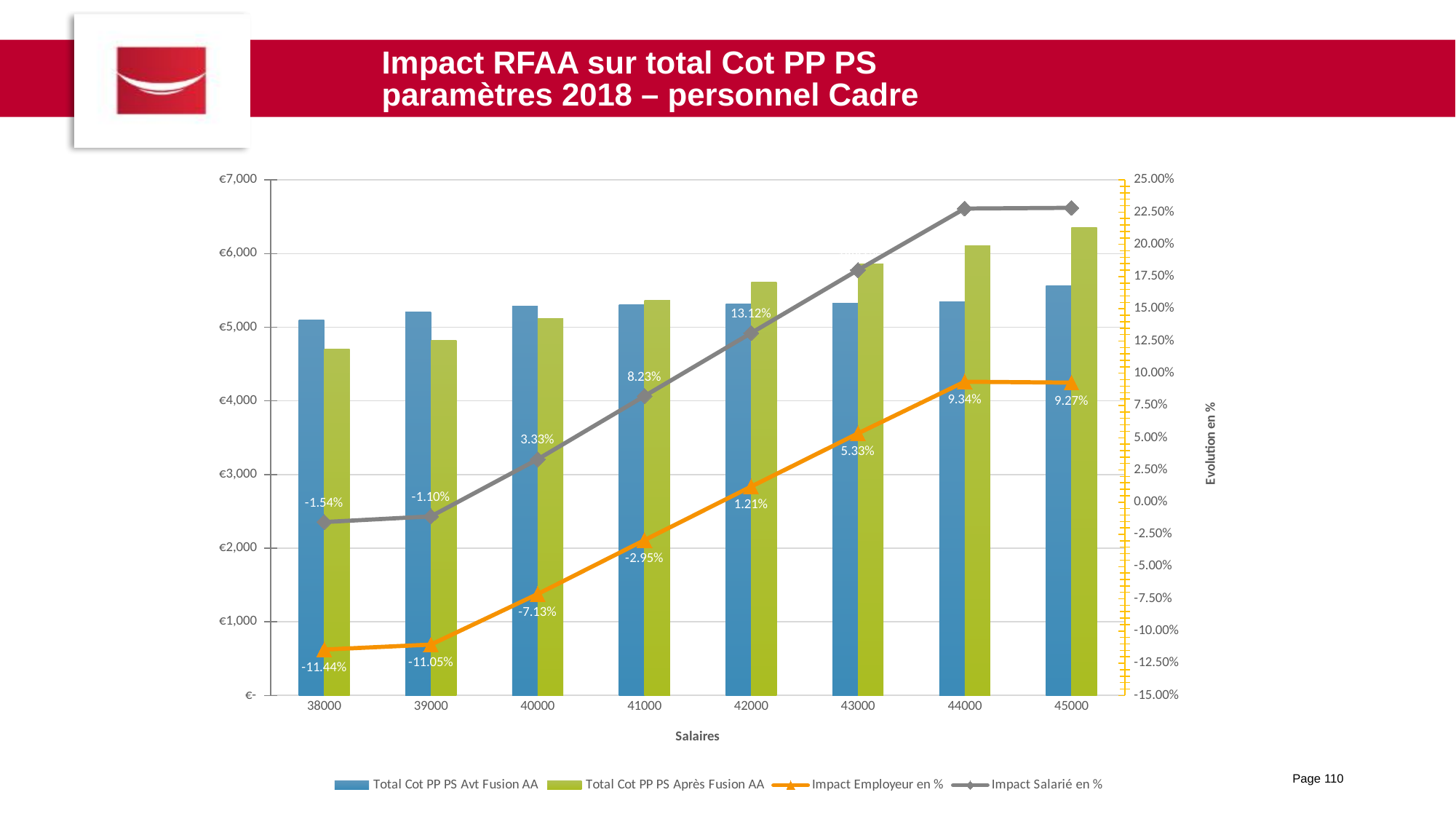
What is the difference between Impact Salarié en % at 41000 and at 40000? 4.90 percentage points Is the Total Cot PP PS Après Fusion AA bar at 38000 greater or less than €5,000? less At a salary of 40000, which is larger: Impact Salarié en % or Impact Employeur en %? Impact Salarié en % How many series does the legend list? 4 Is the Total Cot PP PS Après Fusion AA bar at 45000 greater or less than €6,000? greater What is the value of Impact Salarié en % at a salary of 40000? 3.33% How many salary values are shown on the x axis? 8 What is the value of Impact Employeur en % at a salary of 44000? 9.34% Does Impact Salarié en % rise or fall as salary increases from 38000 to 45000? rise What is the value of Impact Employeur en % at a salary of 38000? -11.44% At which salary is Impact Employeur en % lowest? 38000 What is the value of Impact Salarié en % at a salary of 42000? 13.12%